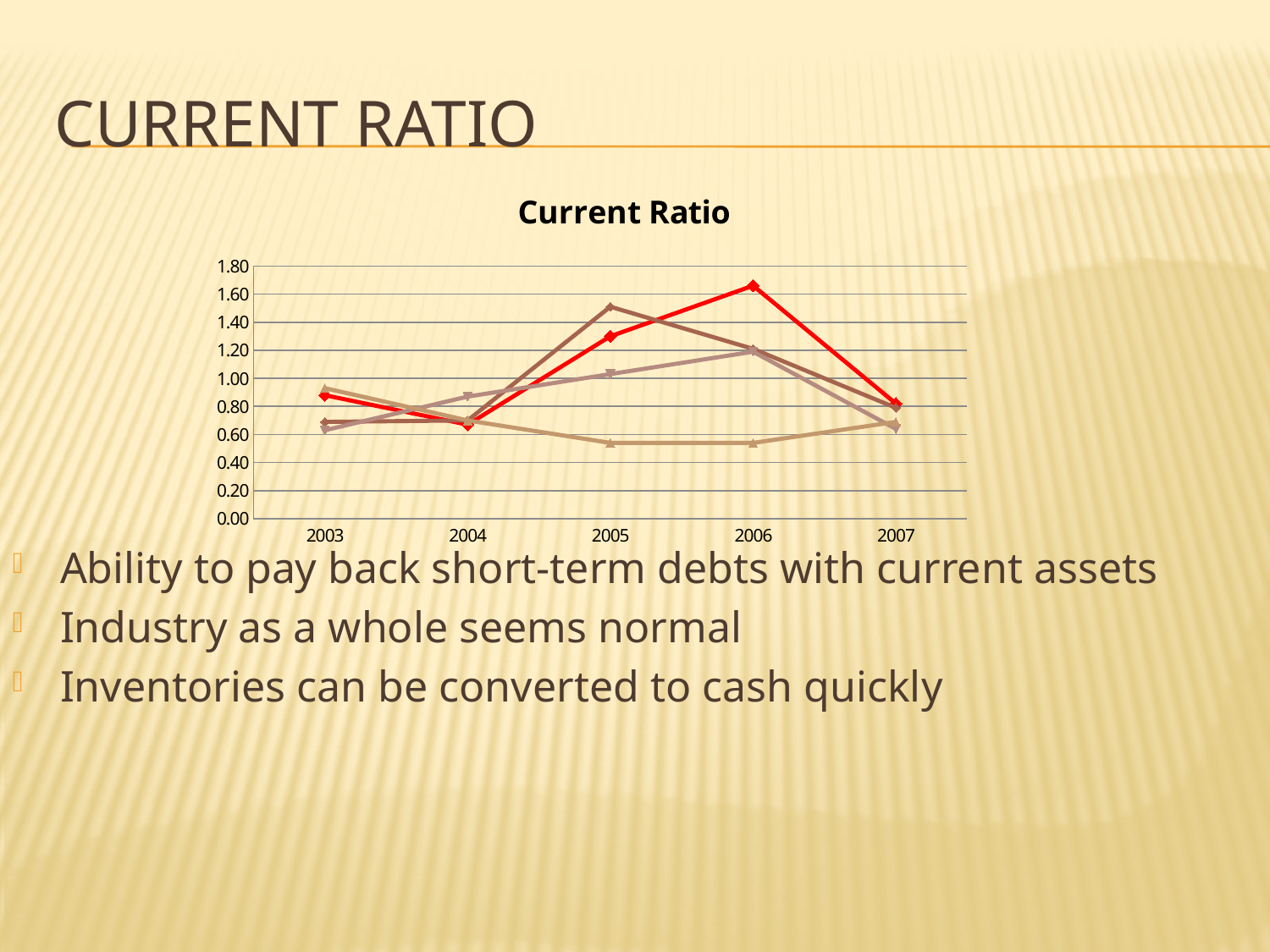
What is the title of the chart? Current Ratio In 2006, which is higher: the red line or the light tan line? the red line Is the value of the light tan line in 2005 greater or less than 0.60? less Does the red line rise or fall from 2006 to 2007? falls How many years are shown on the x axis of the Current Ratio chart? 5 In which year does the red line reach its lowest value? 2004 What kind of chart is shown on the slide? line chart In which year does the red line reach its highest value? 2006 Is the value of the dark brown line in 2005 greater or less than 1.40? greater Is the value of the red line in 2004 greater or less than 0.80? less What is the highest value shown on the y axis of the chart? 1.80